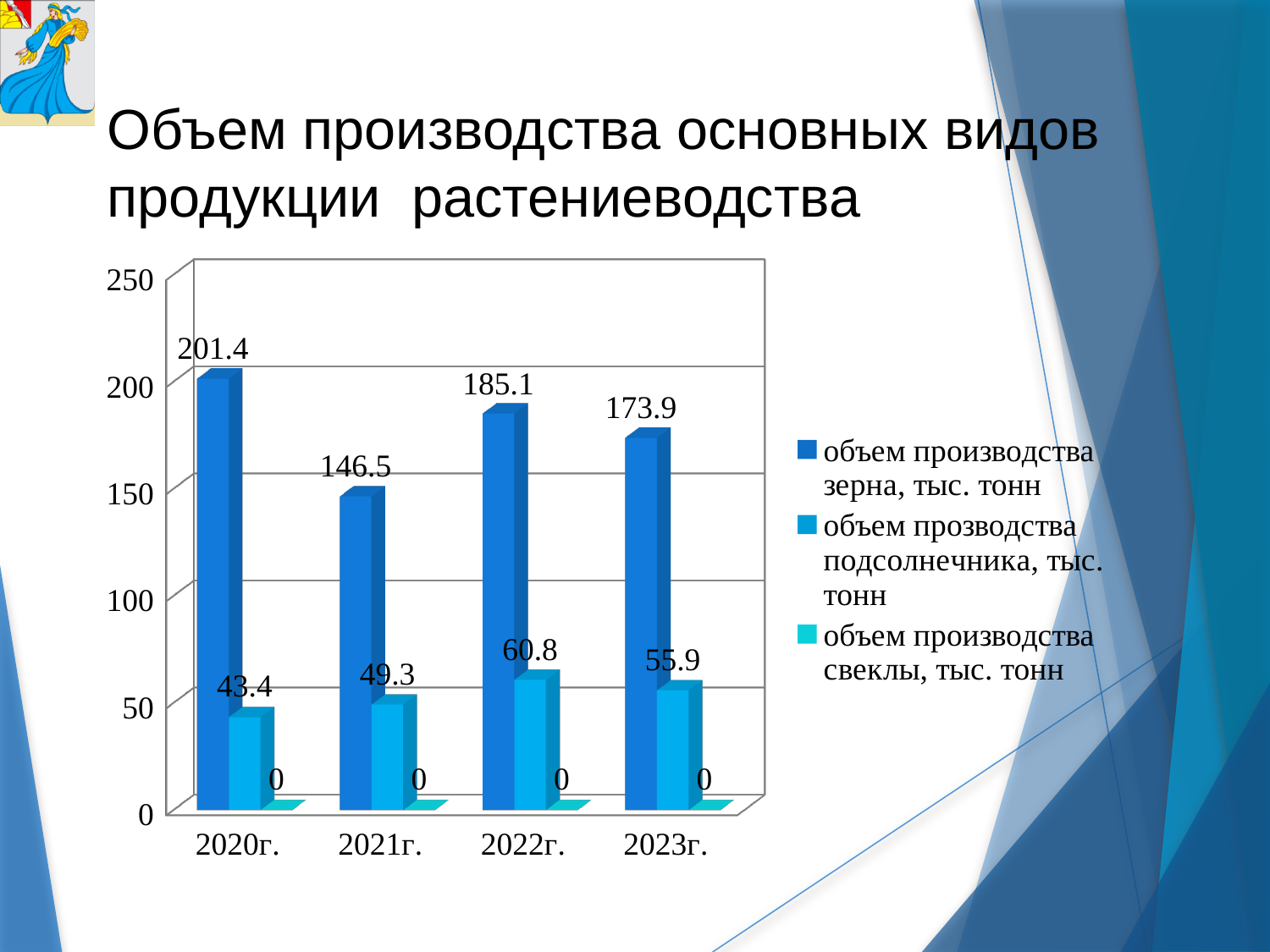
In which year is объем прозводства подсолнечника the lowest? 2020г. What is the title of the slide? Объем производства основных видов продукции растениеводства In which year is объем производства зерна the highest? 2020г. Which is larger: объем прозводства подсолнечника in 2022г. or in 2023г.? 2022г. In which year is объем производства зерна the lowest? 2021г. What is the difference between объем производства зерна in 2020г. and 2021г.? 54.9 How many series does the legend list? 3 What is the value for объем производства зерна in 2020г.? 201.4 What kind of chart is shown on the slide? bar chart What is the value for объем производства свеклы in 2023г.? 0 How many years are shown on the x axis? 4 What is the value for объем прозводства подсолнечника in 2022г.? 60.8